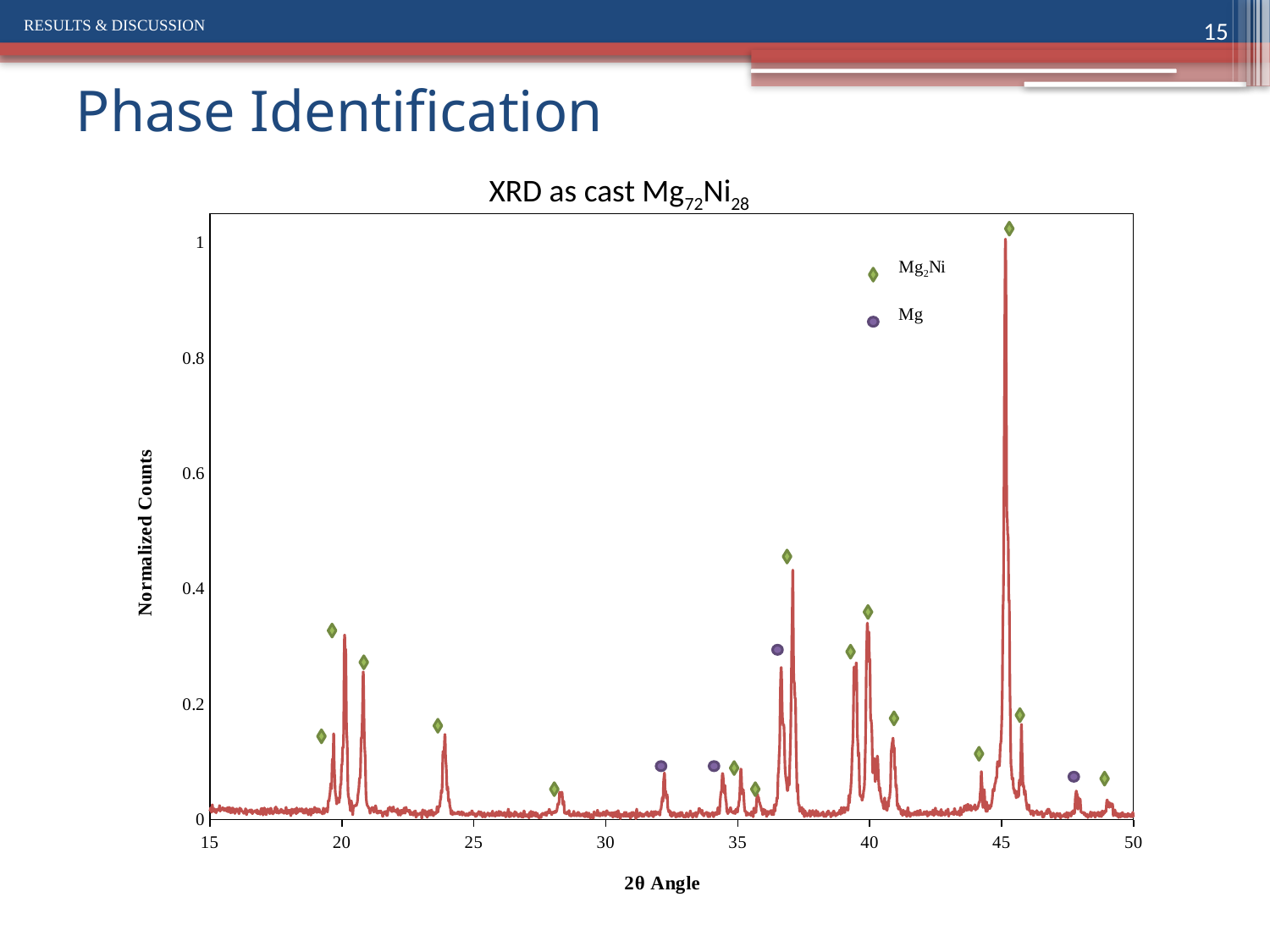
Is the peak near 2θ = 24 greater or less than 0.2 normalized counts? less Which phase is marked with a purple circle in the legend? Mg Which phase is marked with a green diamond in the legend? Mg2Ni Which peak is taller: the one near 2θ = 45 or the one near 2θ = 37? the one near 2θ = 45 Is the peak near 2θ = 37 greater or less than 0.2 normalized counts? greater How many phases does the legend list? 2 Near which 2θ angle tick does the tallest peak occur? 45 Is the tallest peak (near 2θ = 45) greater or less than 0.8 normalized counts? greater What is the title of the chart? XRD as cast Mg72Ni28 How many peaks are marked with the Mg (purple circle) symbol? 4 What kind of chart is shown on the slide? line chart What is the label of the y axis? Normalized Counts